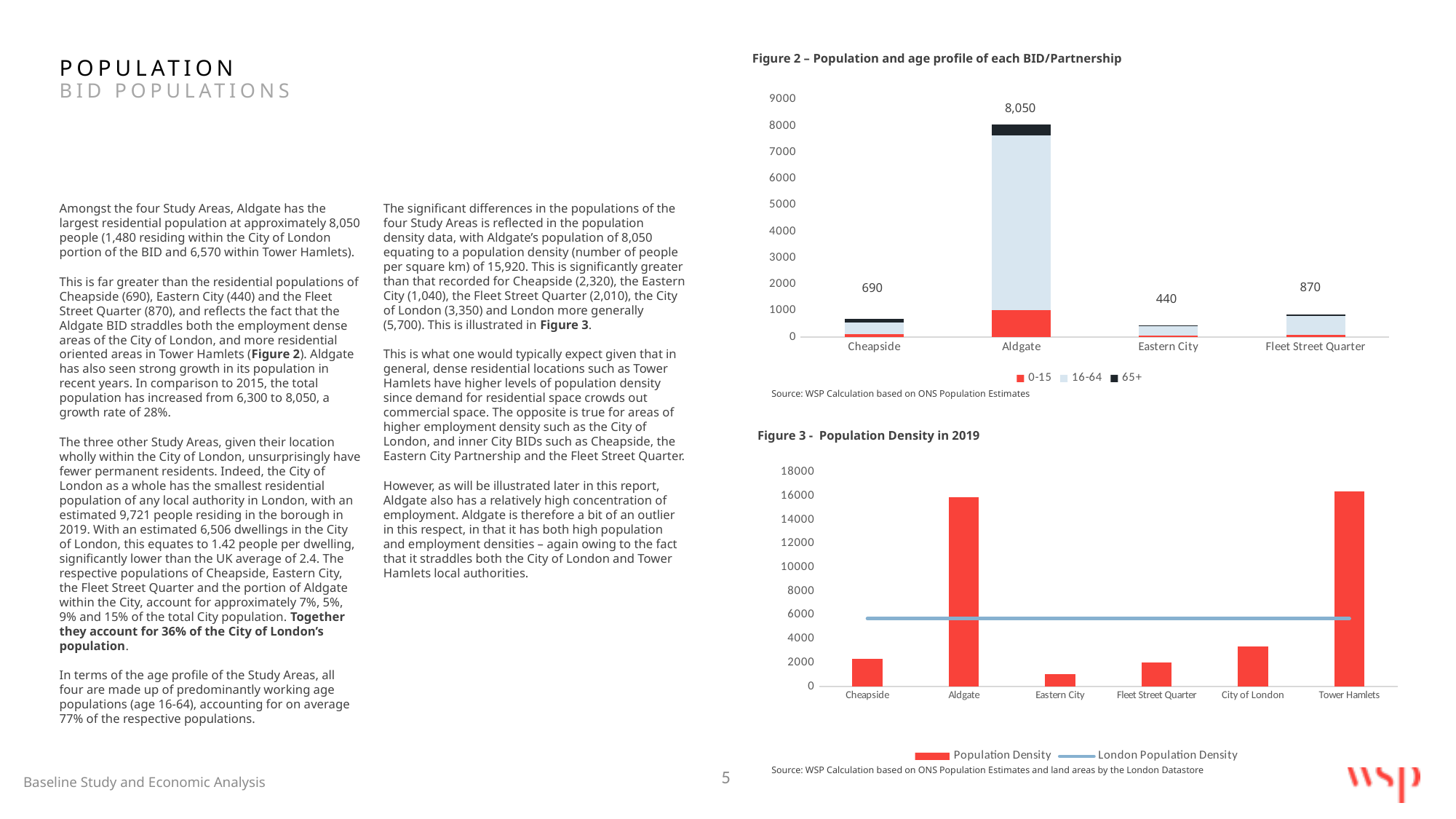
In Figure 2, which BID/Partnership has the largest total population? Aldgate In Figure 2, which age group is shown in red? 0-15 In Figure 2, what is the difference between the total populations of Fleet Street Quarter and Cheapside? 180 In Figure 2, what is the total population shown for Aldgate? 8,050 In Figure 2, what is the total population shown for Eastern City? 440 In Figure 3, is the population density for Eastern City greater or less than 2000? less In Figure 3, which is larger, the population density of City of London or of Fleet Street Quarter? City of London In Figure 3, is the population density for Aldgate greater or less than 14000? greater In Figure 2, how many age groups does the legend list? 3 In Figure 2, which BID/Partnership has the smallest total population? Eastern City In Figure 3, which area has the highest population density? Tower Hamlets In Figure 3, how many areas are shown on the x axis? 6